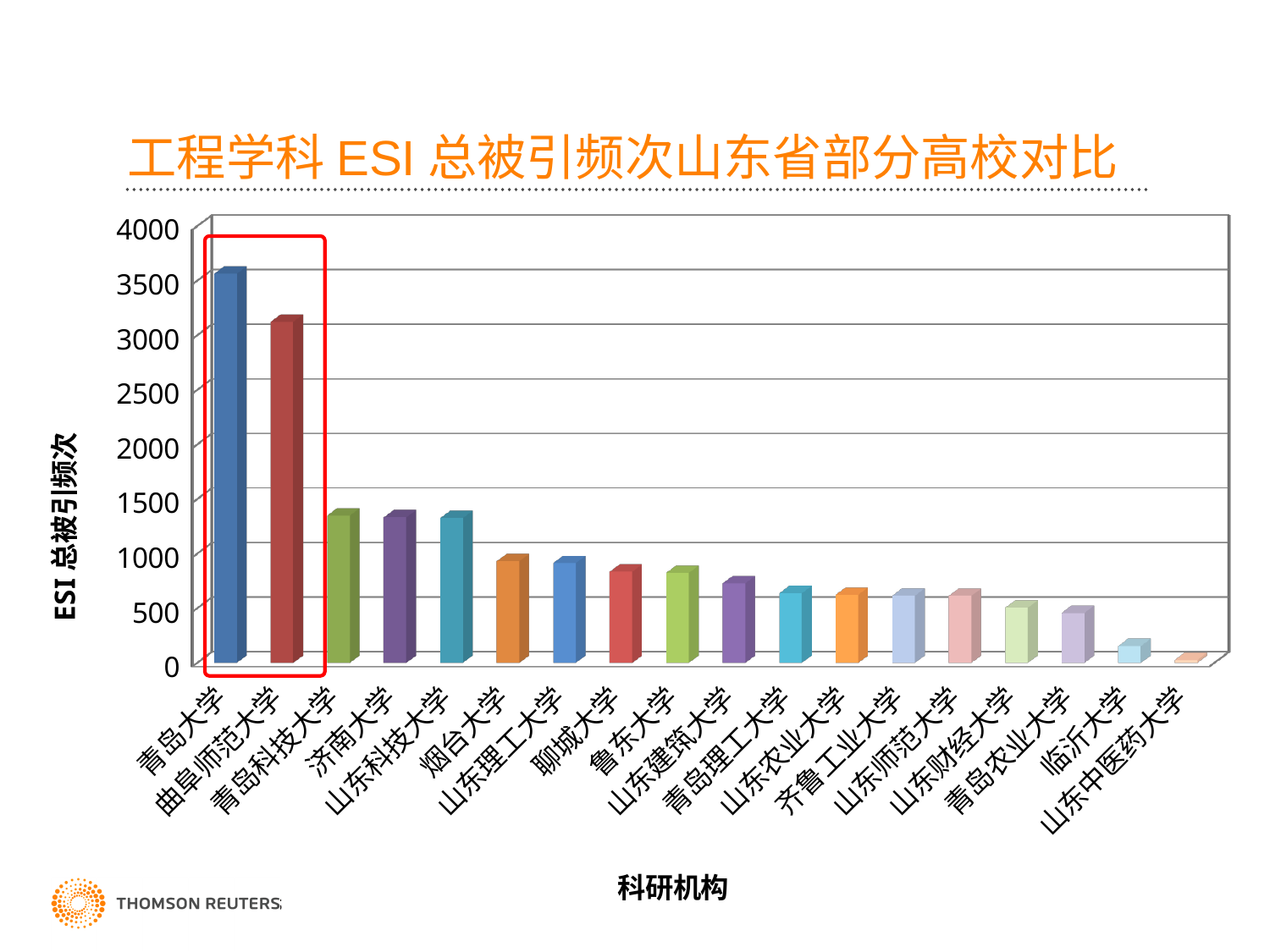
Which university has the highest ESI 总被引频次? 青岛大学 Is the value for 青岛大学 greater or less than 3000? greater Which university has the lowest ESI 总被引频次? 山东中医药大学 Which has a larger value, 青岛大学 or 曲阜师范大学? 青岛大学 Which has a larger value, 山东科技大学 or 烟台大学? 山东科技大学 Is the value for 临沂大学 greater or less than 500? less What is the label of the y axis? ESI 总被引频次 How many universities (categories) are shown on the x axis? 18 Is the value for 烟台大学 greater or less than 1000? less What kind of chart is shown on the slide? Bar chart Do the values rise or fall moving from left to right along the x axis? fall